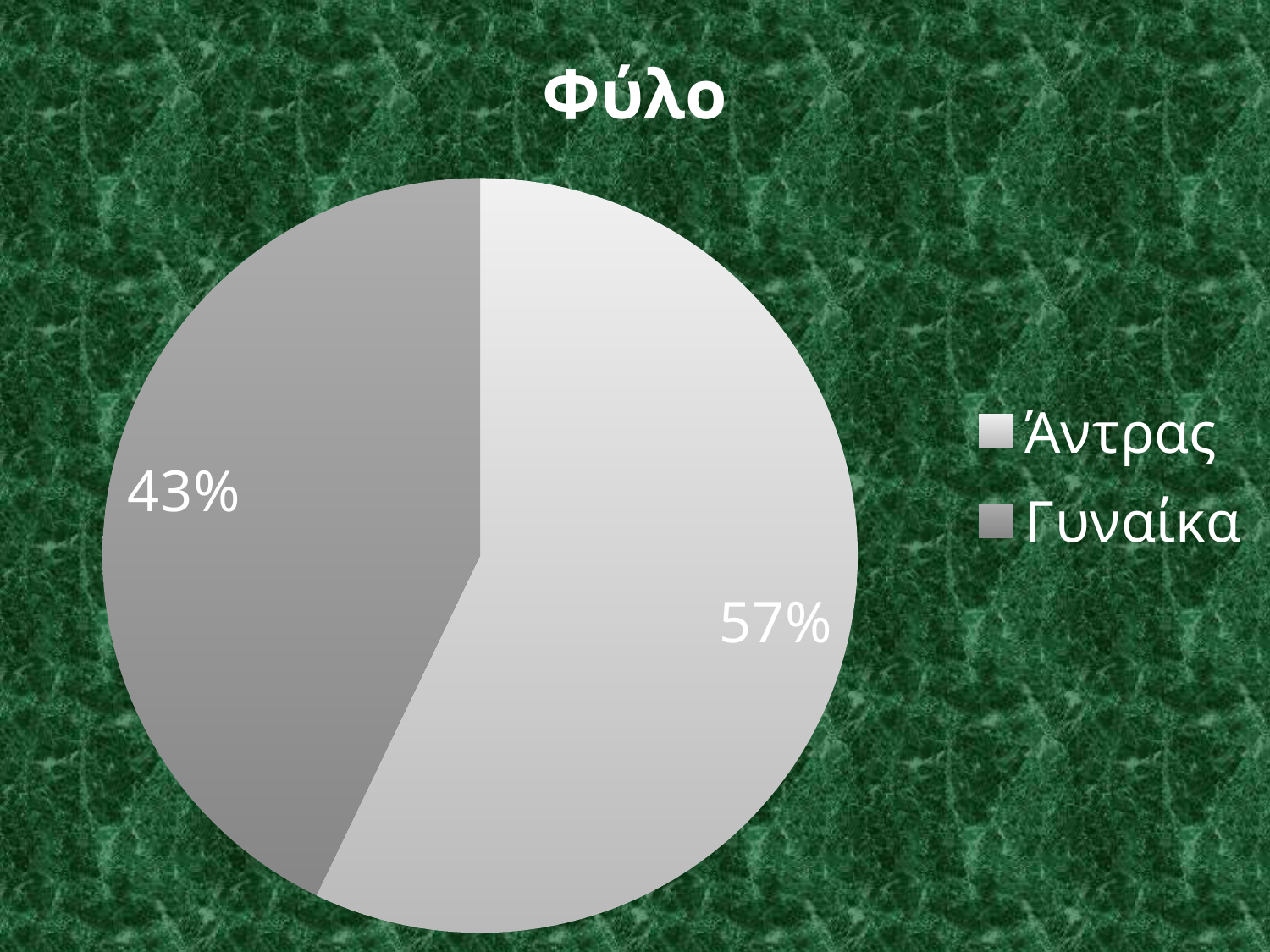
Which category has the largest slice of the pie? Άντρας Is the share for Γυναίκα greater or less than 50%? less What is the difference in percentage points between the Άντρας and Γυναίκα slices? 14 What kind of chart is shown on the slide? Pie chart Which slice is larger, Άντρας or Γυναίκα? Άντρας How many slices does the pie chart have? 2 Which category has the smallest slice of the pie? Γυναίκα What share of the pie does Άντρας represent? 57% Is the share for Άντρας greater or less than 50%? greater What is the title of the chart? Φύλο Which legend entry is shown with the darker grey colour? Γυναίκα What share of the pie does Γυναίκα represent? 43%